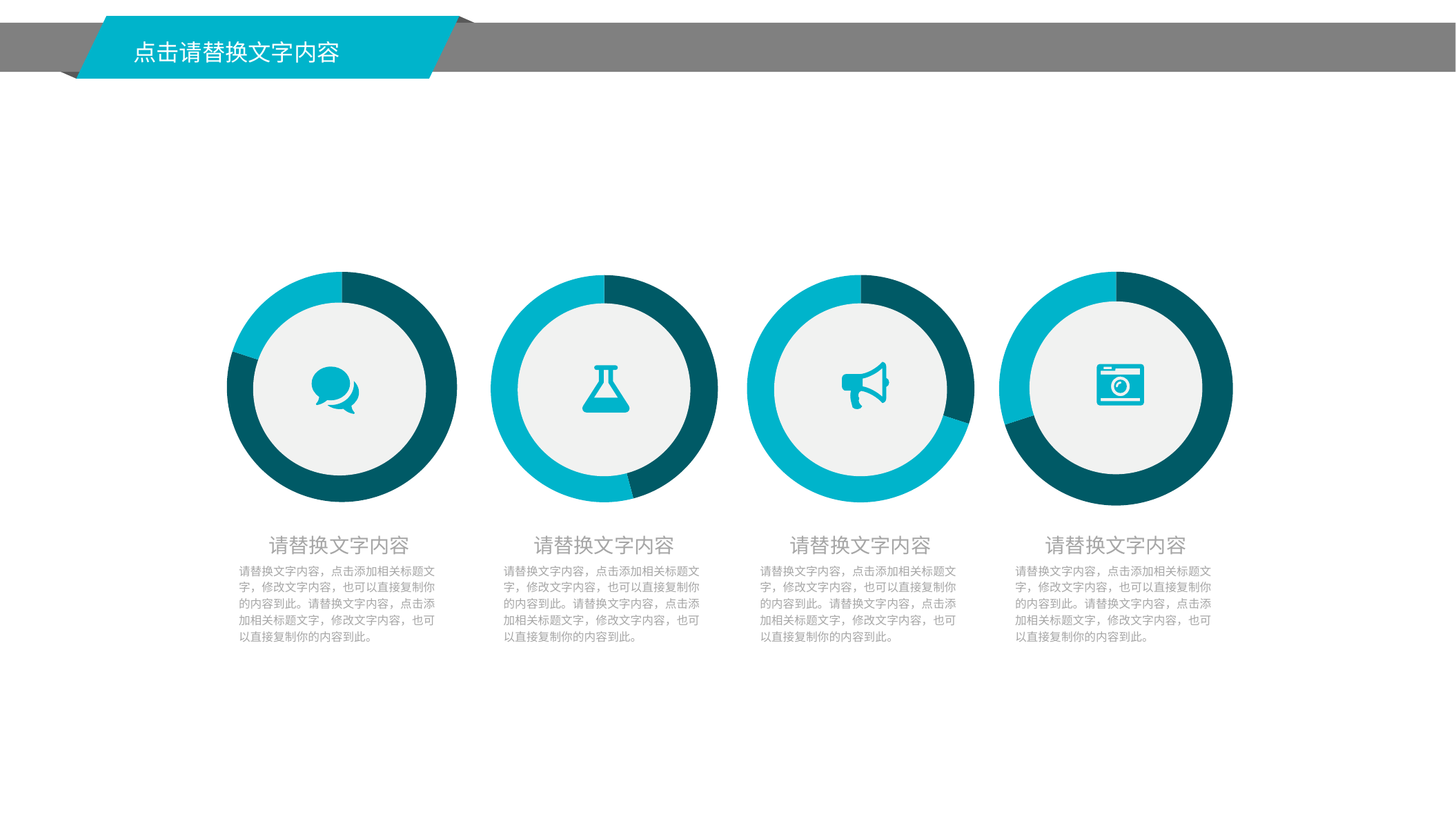
What icon is shown in the centre of the leftmost donut chart? speech bubbles Which donut chart has the largest light cyan share? the third from the left How many donut charts are on the slide? 4 In the leftmost donut chart, which segment is larger, the dark teal one or the light cyan one? dark teal How many segments does the leftmost donut chart have? 2 In the second donut chart from the left, which segment is larger, the dark teal one or the light cyan one? light cyan How many colours are used for the segments in each donut chart? 2 What kind of chart is the leftmost chart on the slide? donut (pie) chart In the rightmost donut chart, which segment is larger, the dark teal one or the light cyan one? dark teal